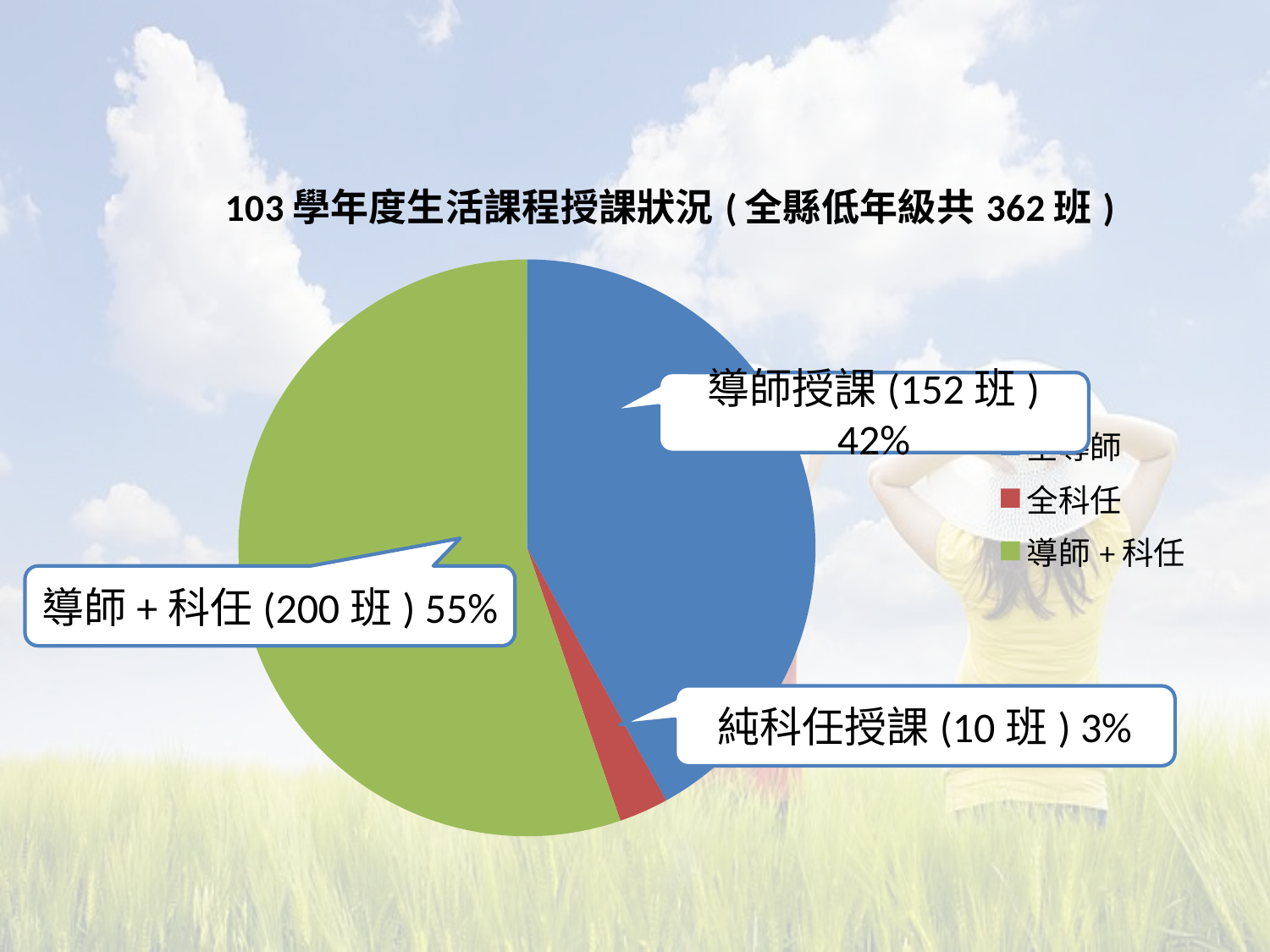
How many classes are taught by 純科任授課 (subject teacher only)? 10 班 How many more classes are in 導師 + 科任 than in 導師授課? 48 班 Which is larger, the number of classes for 導師授課 or for 純科任授課? 導師授課 Which category has the largest slice of the pie? 導師 + 科任 What is the total number of classes stated in the chart title? 362 班 What percentage of classes are taught by 導師 + 科任? 55% What kind of chart is shown on the slide? pie chart How many classes are taught by 導師授課 (homeroom teacher only)? 152 班 How many slices does the pie chart have? 3 What share of the pie does 純科任授課 represent? 3% Which category has the smallest slice of the pie? 純科任授課 What share of the pie does 導師授課 represent? 42%